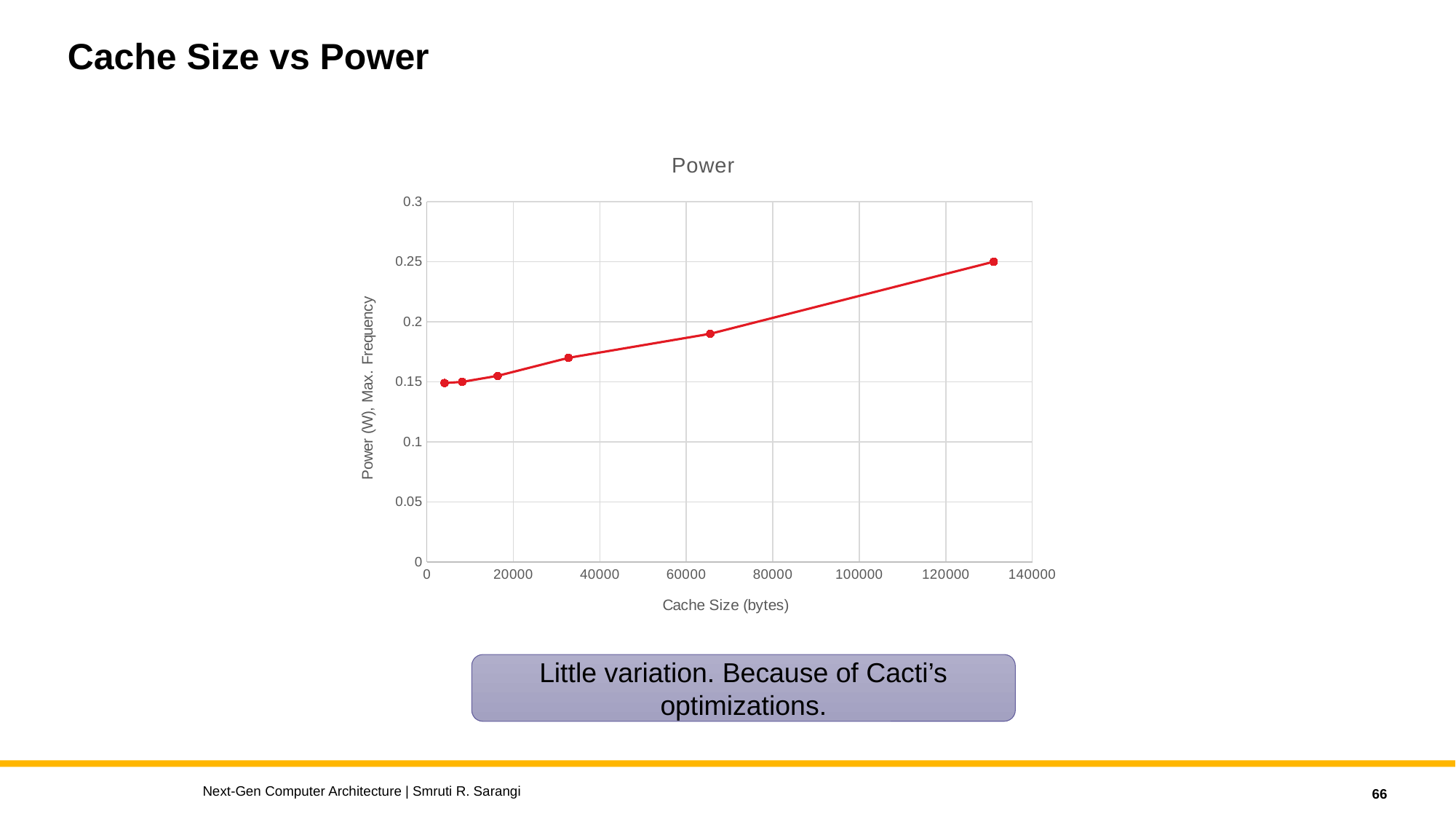
What kind of chart is shown on the slide? line chart Which data point has the lowest power value? the point at the smallest cache size Is the power value for the largest cache size greater or less than 0.2? greater Is the power value for the cache size near 65000 bytes greater or less than 0.2? less Is the power value for the cache size near 33000 bytes greater or less than 0.15? greater Which data point has the highest power value? the point at the largest cache size What is the label of the x axis? Cache Size (bytes) How many data points are plotted on the Power chart? 6 Does power rise or fall as cache size increases along the x axis? rise What is the title of the chart? Power Which has the larger power value: the point at the largest cache size or the point at the smallest cache size? the point at the largest cache size